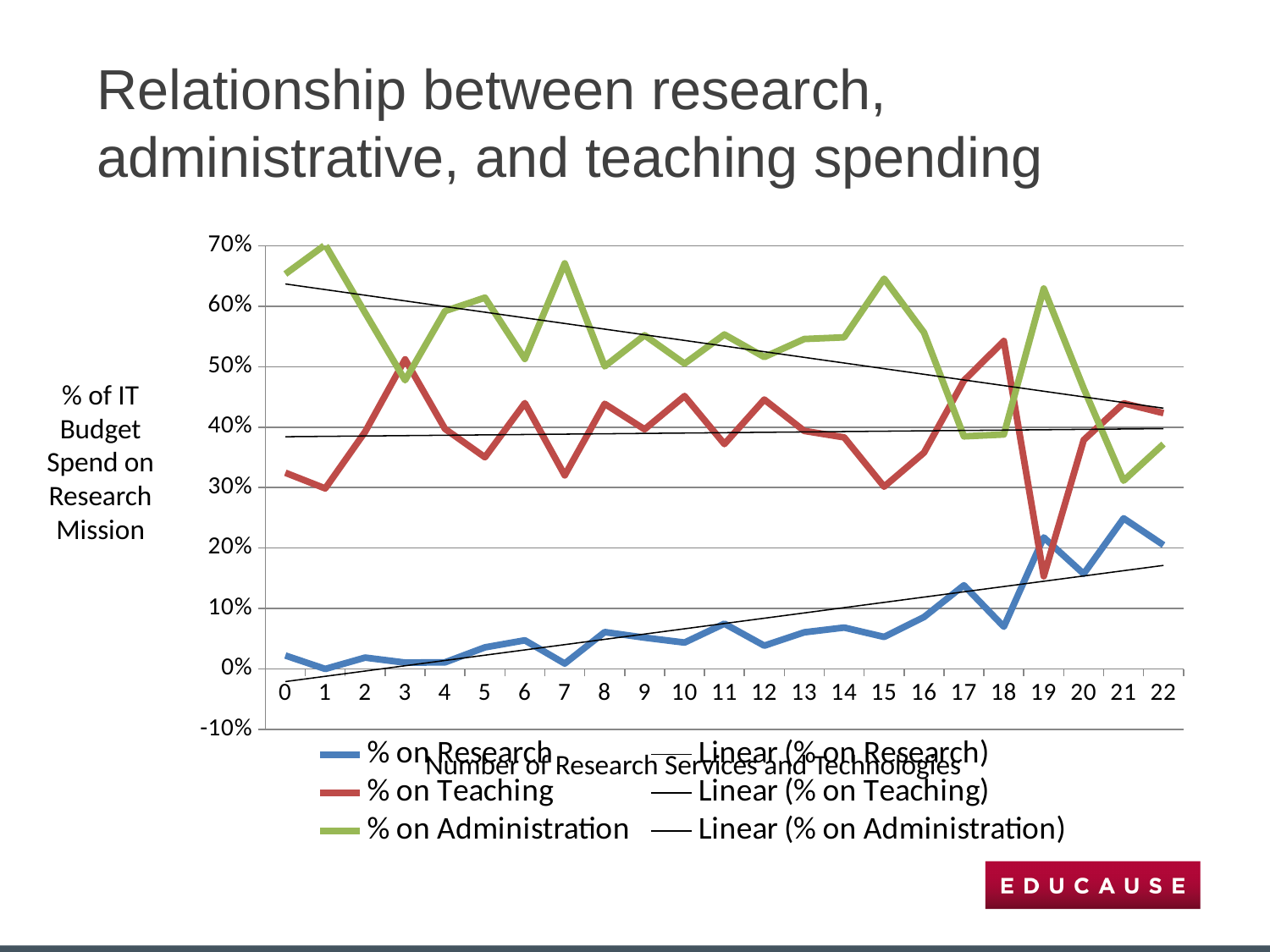
What kind of chart is shown on the slide? line chart Does the % on Administration line generally rise or fall as the number of research services increases from 0 to 22? fall At which x-axis value is % on Teaching lowest? 19 At which x-axis value is % on Administration highest? 1 Is the value for % on Research at x = 21 greater or less than 20%? greater What is the title of the x axis? Number of Research Services and Technologies At which x-axis value is % on Research highest? 21 Does the % on Research line generally rise or fall as the number of research services increases from 0 to 22? rise Is the value for % on Administration at x = 1 greater or less than 60%? greater At x = 19, which is larger: % on Research or % on Teaching? % on Research How many entries does the chart's legend list? 6 How many x-axis categories (0 through 22) are plotted on the chart? 23